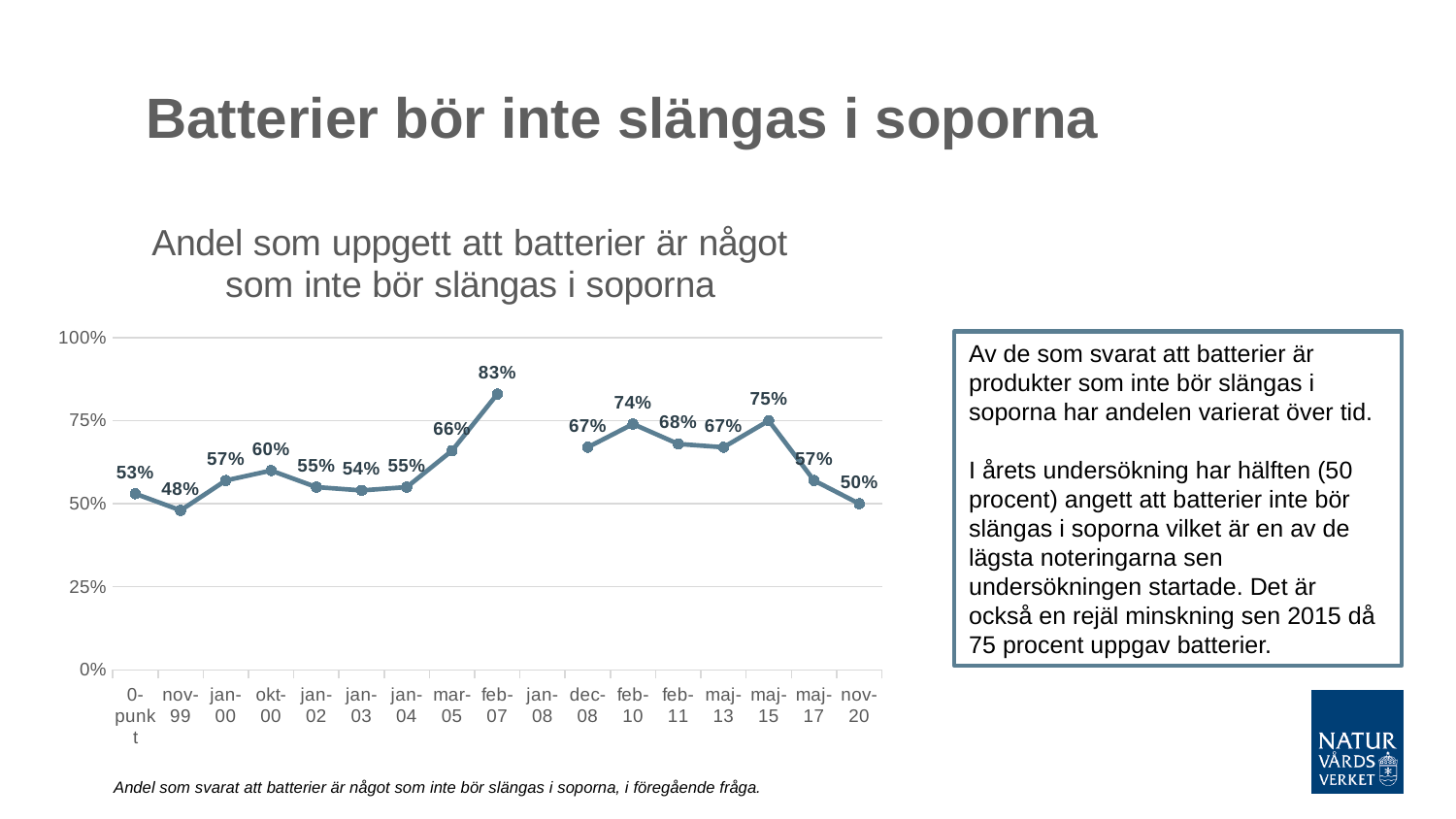
Which category has the lowest value? nov-99 What is the difference between the values for feb-07 and mar-05? 17% What is the value for nov-99? 48% What is the title of the chart? Andel som uppgett att batterier är något som inte bör slängas i soporna What is the value for maj-15? 75% What kind of chart is shown on the slide? line chart How many category labels are on the x axis? 17 What is the difference between the values for maj-15 and nov-20? 25% What is the value for feb-07? 83% What is the value for nov-20? 50% Which is larger, the value for feb-10 or the value for feb-11? feb-10 Which category has the highest value? feb-07